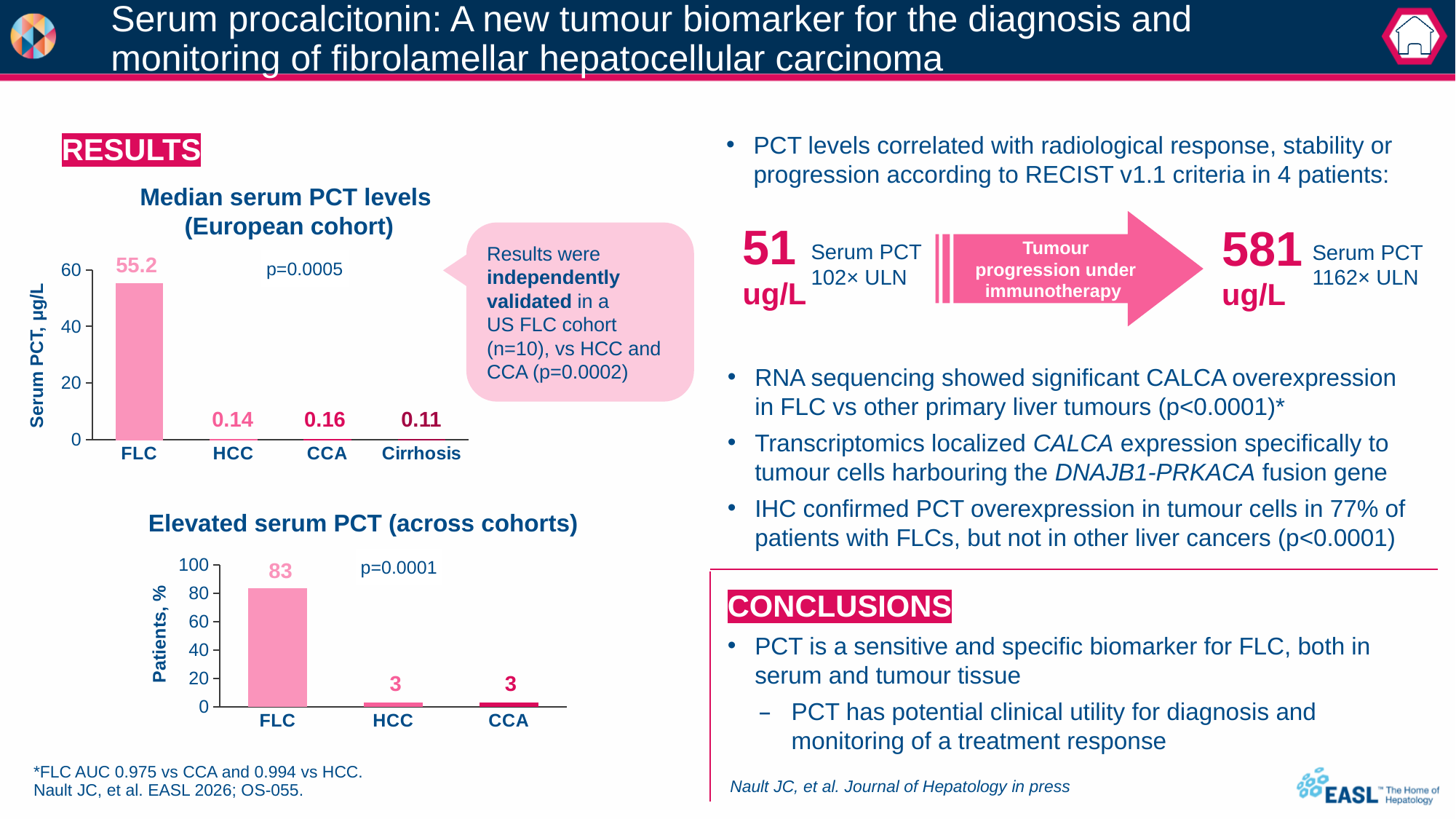
In the 'Median serum PCT levels (European cohort)' chart, what is the value for FLC? 55.2 In the 'Elevated serum PCT (across cohorts)' chart, what is the difference between the FLC and HCC values? 80 What kind of chart is the 'Elevated serum PCT (across cohorts)' chart? Bar chart In the 'Median serum PCT levels (European cohort)' chart, how many categories are shown on the x axis? 4 In the 'Elevated serum PCT (across cohorts)' chart, is the value for FLC greater or less than 80? greater In the 'Median serum PCT levels (European cohort)' chart, which category has the highest value? FLC In the 'Median serum PCT levels (European cohort)' chart, what is the p-value shown? p=0.0005 In the 'Median serum PCT levels (European cohort)' chart, what is the value for Cirrhosis? 0.11 In the 'Elevated serum PCT (across cohorts)' chart, what is the value for FLC? 83 In the 'Median serum PCT levels (European cohort)' chart, what is the difference between the FLC and HCC values? 55.06 In the 'Elevated serum PCT (across cohorts)' chart, what is the y-axis label? Patients, % In the 'Elevated serum PCT (across cohorts)' chart, what is the value for CCA? 3